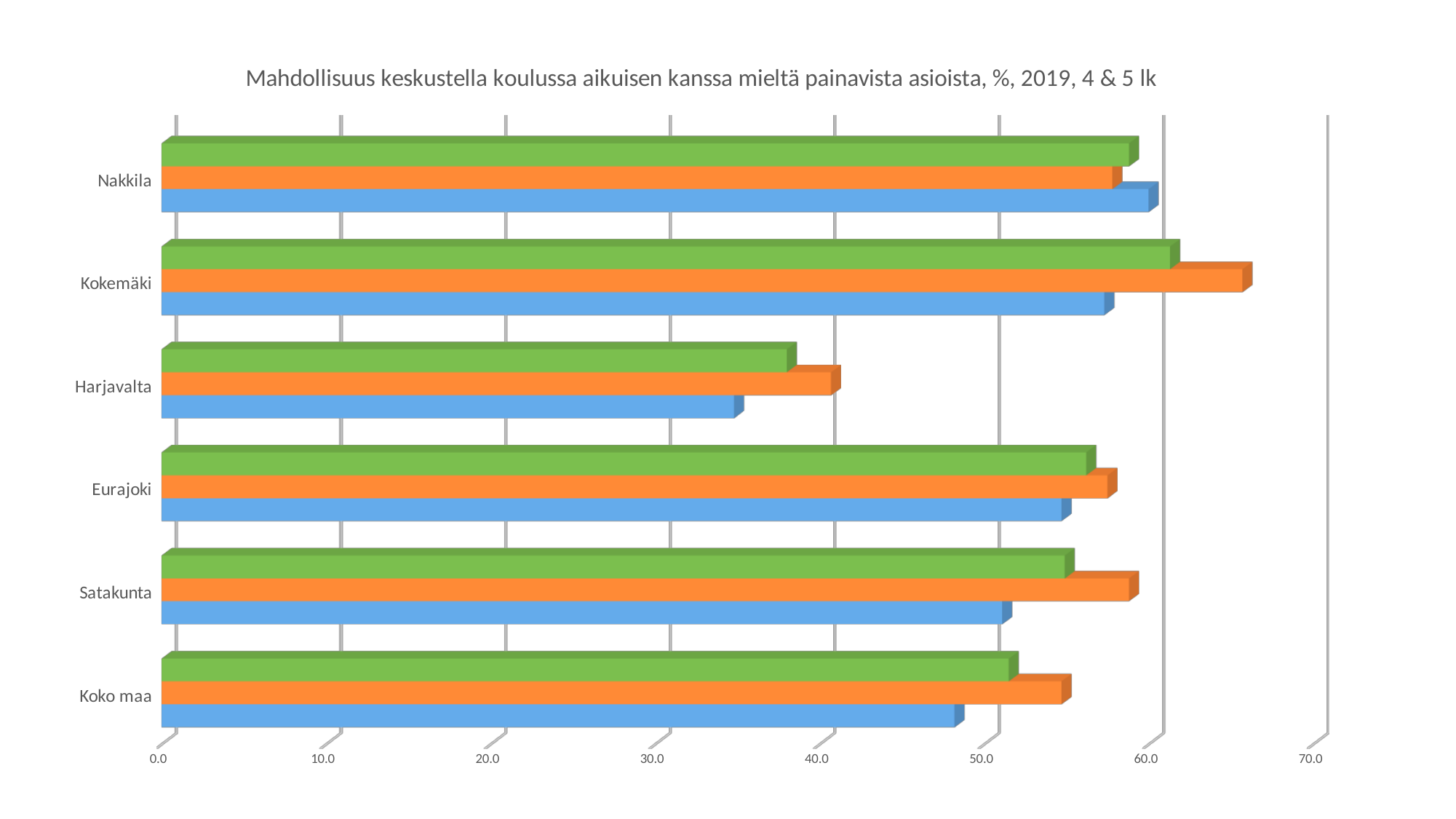
Which category has the lowest values across all its bars? Harjavalta What is the highest value shown on the horizontal axis of the chart? 70.0 Is the value of the orange bar for Kokemäki greater or less than 60? greater Is the value of the blue bar for Harjavalta greater or less than 40? less What is the title of the chart? Mahdollisuus keskustella koulussa aikuisen kanssa mieltä painavista asioista, %, 2019, 4 & 5 lk Is the value of the blue bar for Koko maa greater or less than 50? less How many categories are shown on the vertical axis of the chart? 6 Which category has the longest orange bar? Kokemäki Which is larger, the orange bar for Harjavalta or the orange bar for Kokemäki? Kokemäki How many bars are shown for each category in the chart? 3 What kind of chart is shown on the slide? bar chart